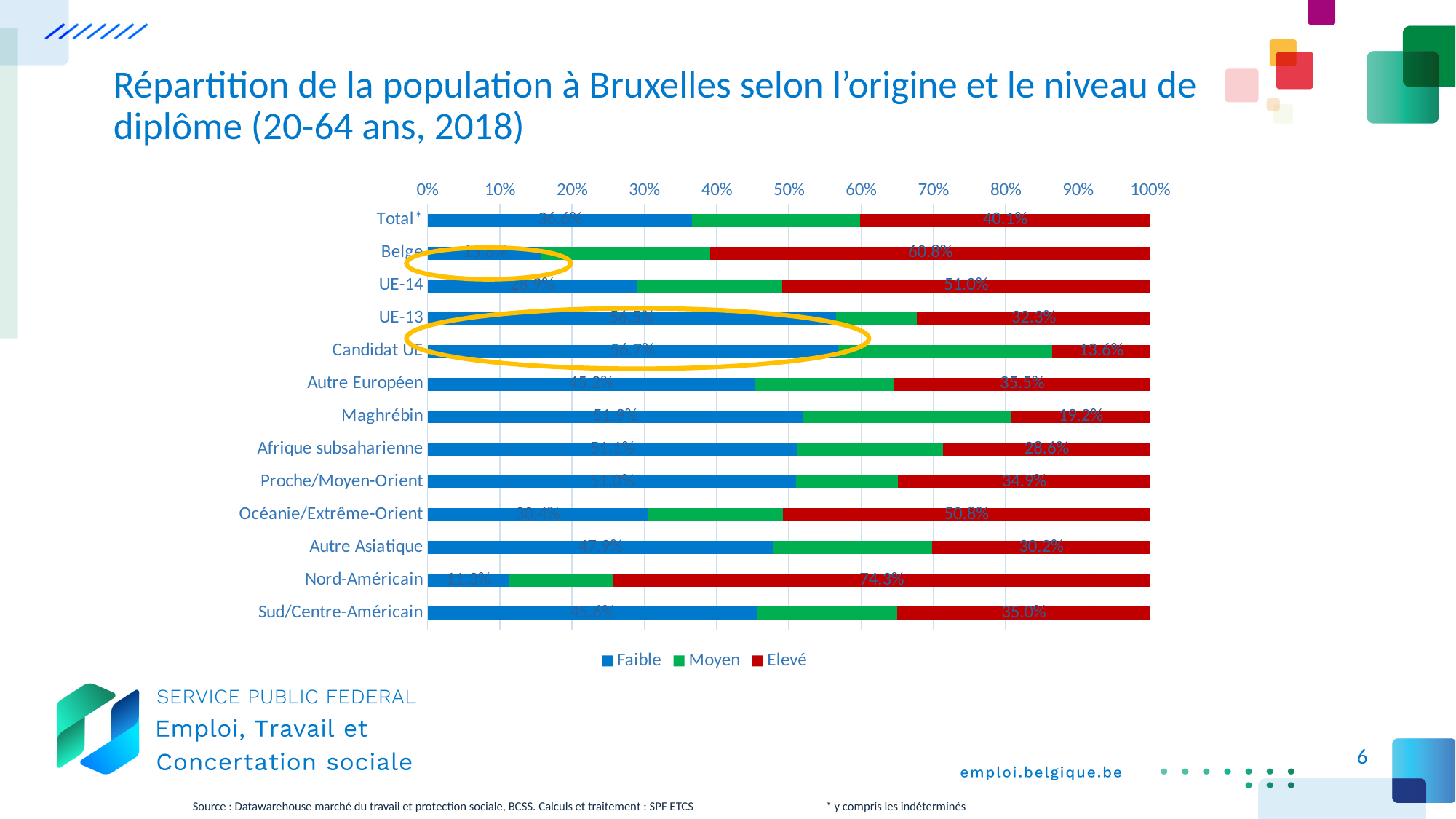
What is the Faible share for Candidat UE? 56.7% How many origin categories are plotted on the chart? 13 How many series does the legend list? 3 What is the Elevé share for Nord-Américain? 74.3% Which origin category has the highest Elevé share? Nord-Américain Which has a larger Elevé share, Belge or UE-14? Belge What are the three legend entries of the chart? Faible, Moyen, Elevé Which origin category has the lowest Elevé share? Candidat UE What is the Elevé share for Belge? 60.8% What is the Elevé share for Total*? 40.1% What kind of chart is shown on the slide? Stacked bar chart What is the difference between the Elevé share for Nord-Américain and for Candidat UE? 60.7 percentage points